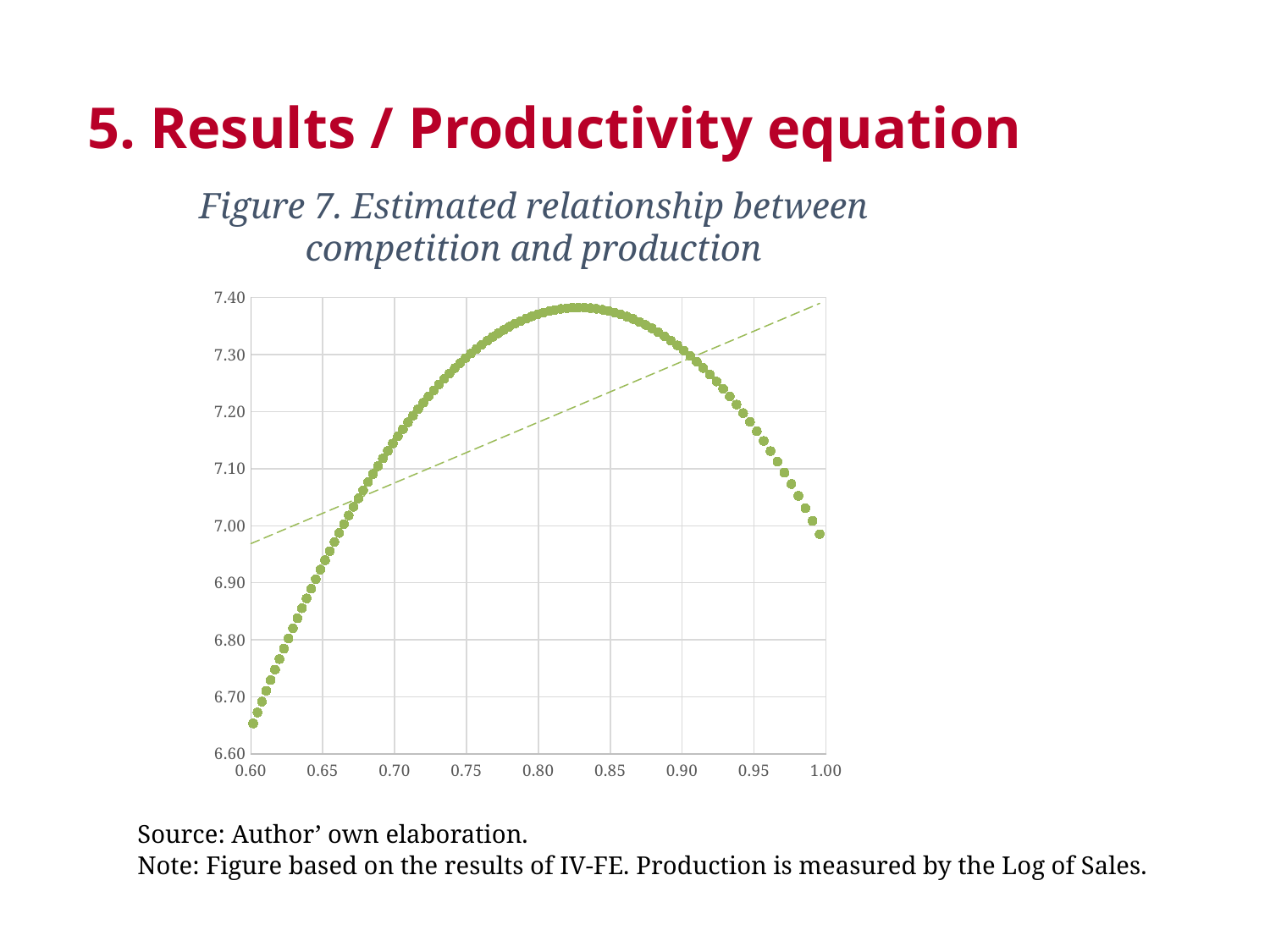
Is the plotted value at x = 0.90 greater or less than 7.20? greater Do the plotted values rise or fall as the x axis moves from 0.60 to about 0.80? rise Do the plotted values rise or fall as the x axis moves from about 0.85 to 1.00? fall What kind of chart is shown in Figure 7? scatter chart Does the dashed straight line rise or fall along the x axis? rise Is the plotted value at x = 0.80 greater or less than 7.30? greater Is the plotted value at x = 0.75 greater or less than 7.20? greater Which is larger, the plotted value at x = 0.80 or at x = 0.60? x = 0.80 What is the title of the figure on the slide? Figure 7. Estimated relationship between competition and production What is the highest value shown on the y axis? 7.40